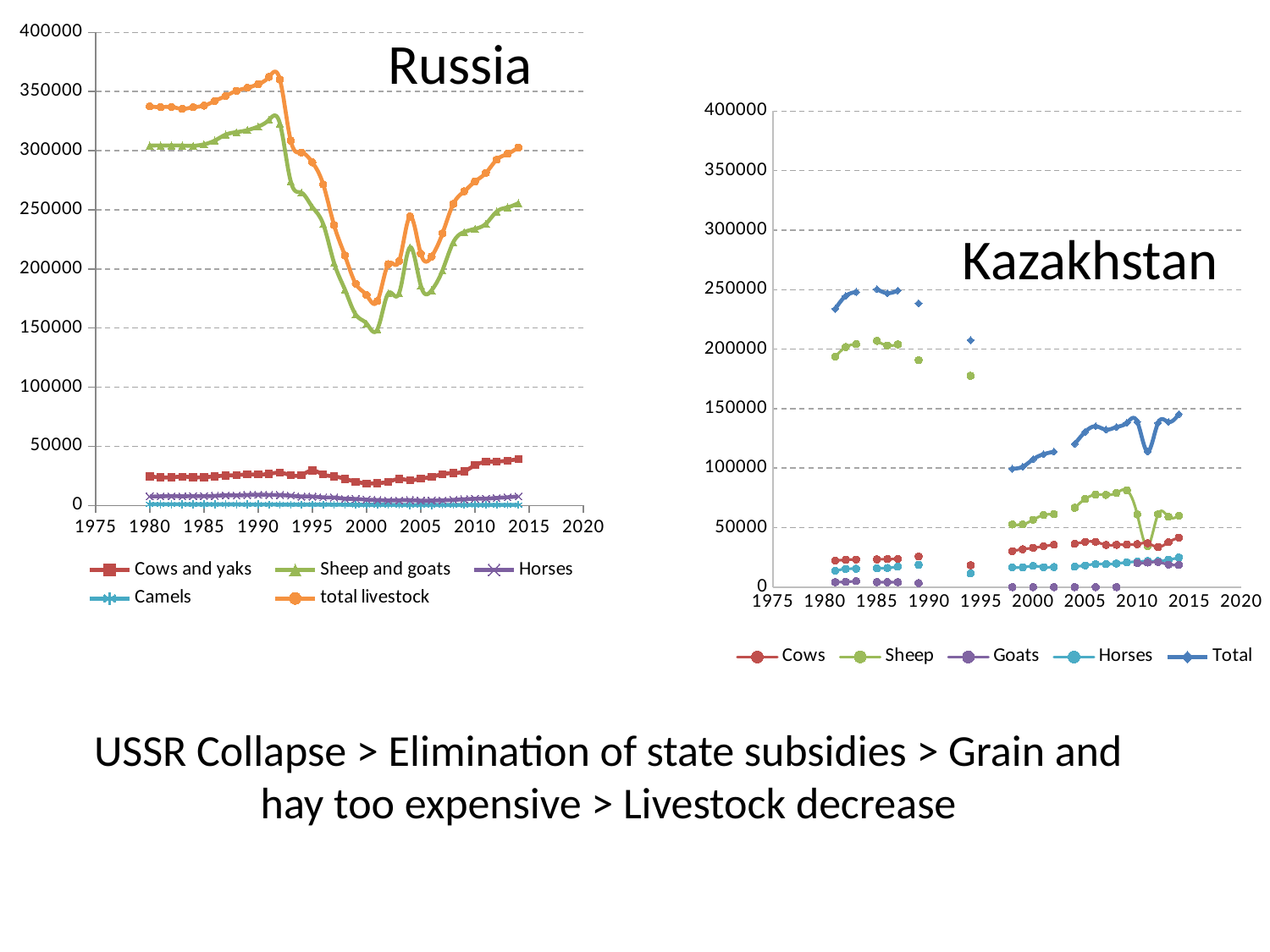
In the Russia chart, which series has the lowest values throughout? Camels What type of chart is the Russia chart? line chart In the Russia chart, does total livestock rise or fall between 1992 and 2001? fall In the Russia chart, is the value for total livestock in 1980 greater or less than 300000? greater In the Kazakhstan chart, is the value for Total in 2014 greater or less than 100000? greater How many series does the legend of the Russia chart list? 5 In the Kazakhstan chart, which is larger in 2005, Sheep or Cows? Sheep In the Kazakhstan chart, is the value for Total in 1985 greater or less than 200000? greater In the Russia chart, which series has the highest values throughout? total livestock In the Kazakhstan chart, which series has the lowest values? Goats How many series does the legend of the Kazakhstan chart list? 5